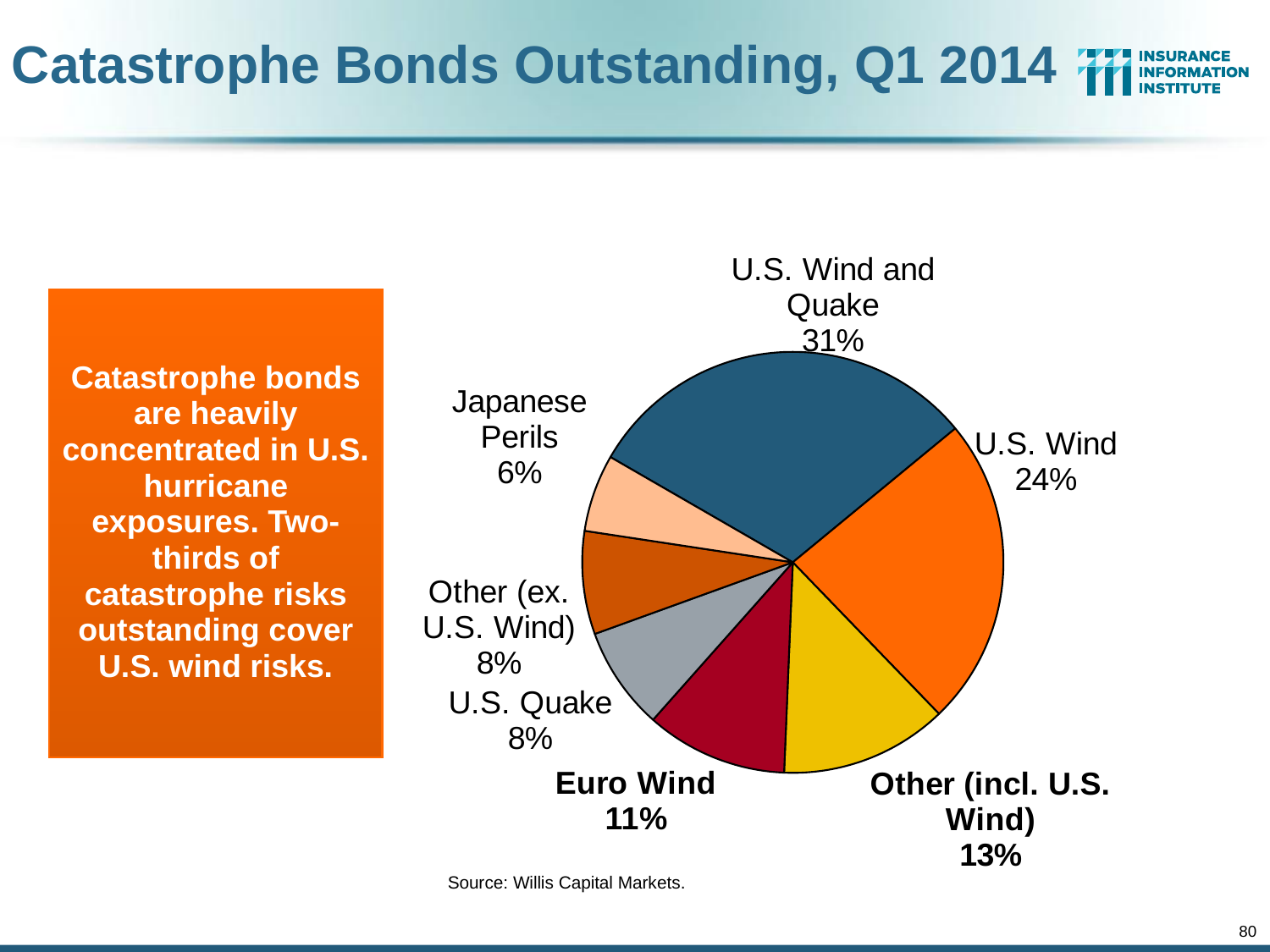
What share of catastrophe bonds outstanding is for U.S. Wind? 24% What type of chart is shown on the slide? Pie chart What share of catastrophe bonds outstanding is for Japanese Perils? 6% How many slices does the pie chart have? 7 Which category has the largest share of catastrophe bonds outstanding? U.S. Wind and Quake Which category has the smallest share of catastrophe bonds outstanding? Japanese Perils What is the title of the slide containing the chart? Catastrophe Bonds Outstanding, Q1 2014 What share of catastrophe bonds outstanding is for Euro Wind? 11% What is the difference in percentage points between the U.S. Wind and Quake share and the U.S. Wind share? 7 Which is larger: the share for Euro Wind or the share for Other (incl. U.S. Wind)? Other (incl. U.S. Wind) What share of catastrophe bonds outstanding is for Other (incl. U.S. Wind)? 13% What share of catastrophe bonds outstanding is for U.S. Wind and Quake? 31%